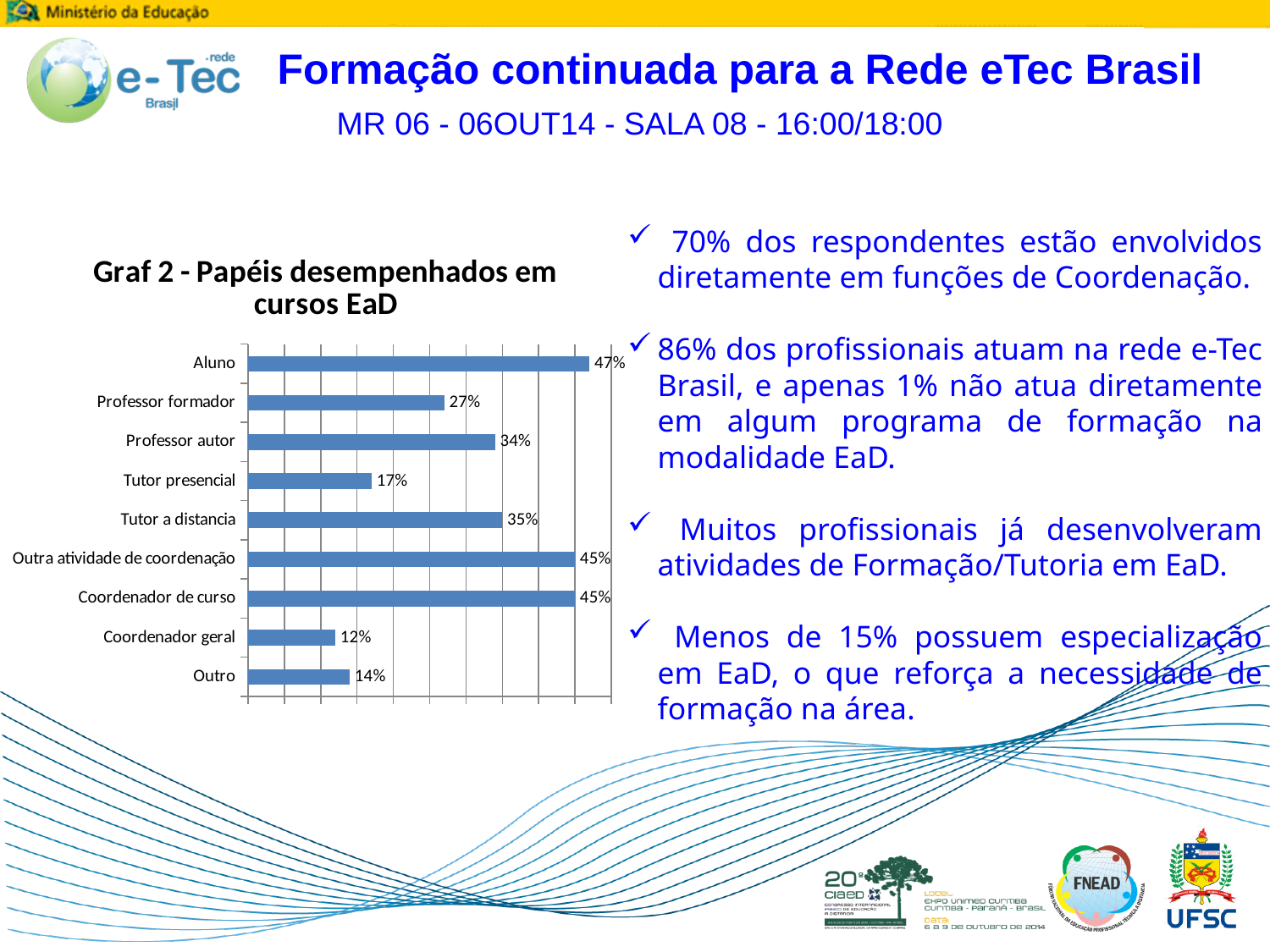
What is the value for Professor autor? 34% What is the value for Aluno? 47% Which category has the highest value? Aluno What is the value for Tutor presencial? 17% Which category has the lowest value? Coordenador geral What type of chart is shown on the slide? bar chart How many categories are shown in the chart? 9 What is the difference between the values for Aluno and Professor formador? 20% What is the value for Coordenador de curso? 45% What is the difference between the values for Tutor a distancia and Tutor presencial? 18% What is the title of the chart? Graf 2 - Papéis desempenhados em cursos EaD Which is larger, the value for Professor autor or the value for Professor formador? Professor autor